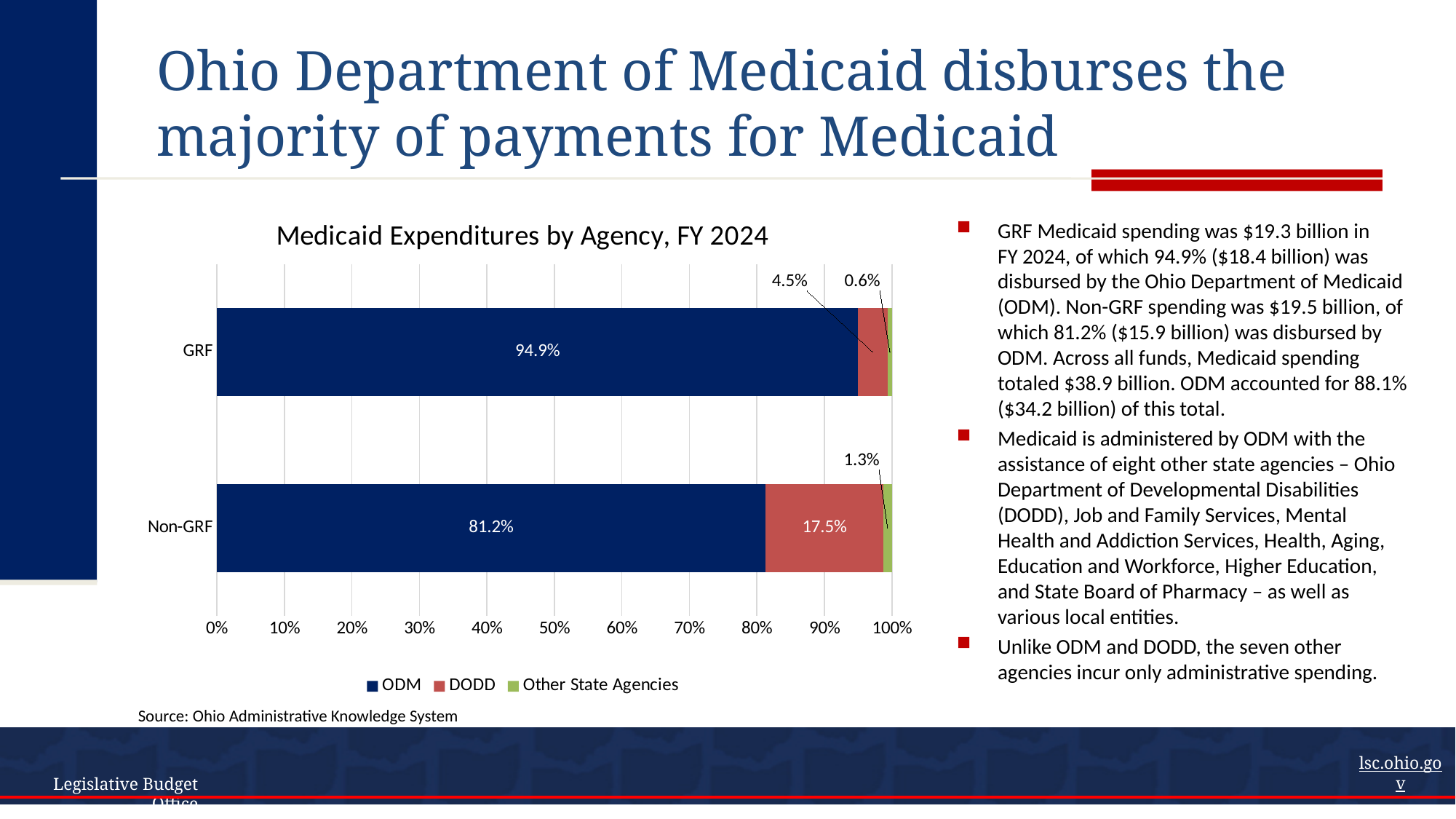
What is the DODD share of GRF Medicaid expenditures? 4.5% What is the title of the chart? Medicaid Expenditures by Agency, FY 2024 What is the DODD share of Non-GRF Medicaid expenditures in the chart? 17.5% What is the Other State Agencies share of Non-GRF Medicaid expenditures? 1.3% What is the ODM share of GRF Medicaid expenditures in the chart? 94.9% How many fund categories are shown on the y axis? 2 What kind of chart is shown on the slide? Stacked bar chart Which fund category has the higher ODM share, GRF or Non-GRF? GRF How many series does the legend list? 3 What is the difference between the DODD share for Non-GRF and the DODD share for GRF? 13.0% What is the difference between the ODM share for GRF and the ODM share for Non-GRF? 13.7% What is the Other State Agencies share of GRF Medicaid expenditures? 0.6%